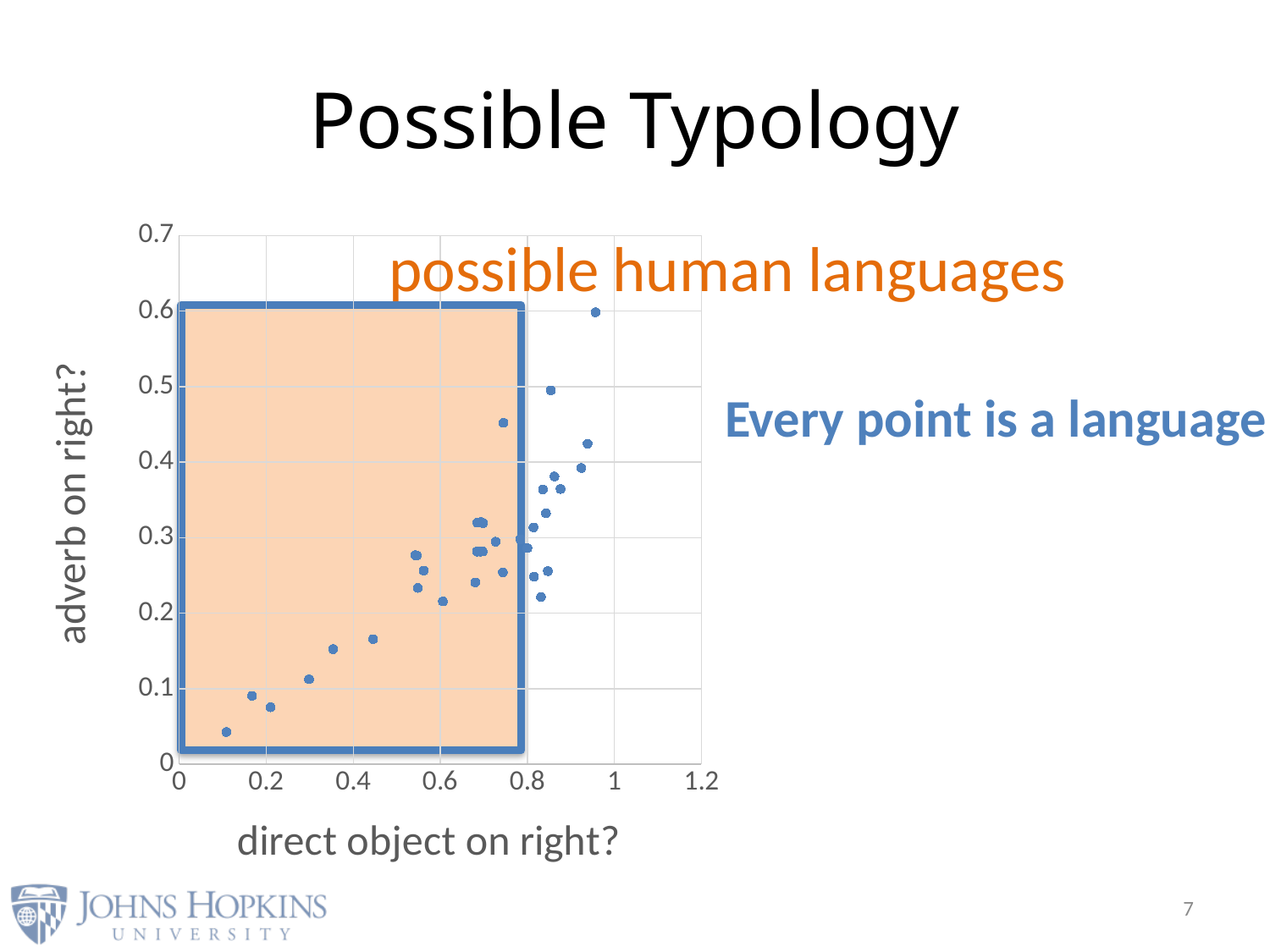
What is the label of the x axis? direct object on right? Is the x value of the rightmost point greater or less than 1? less Do the values of 'adverb on right?' generally rise or fall as 'direct object on right?' increases along the x axis? rise Is the x value of the highest point greater or less than 0.8? greater Is the y value of the point with the largest x value greater or less than 0.4? greater What is the label of the y axis? adverb on right? What kind of chart is shown on the slide? scatter plot